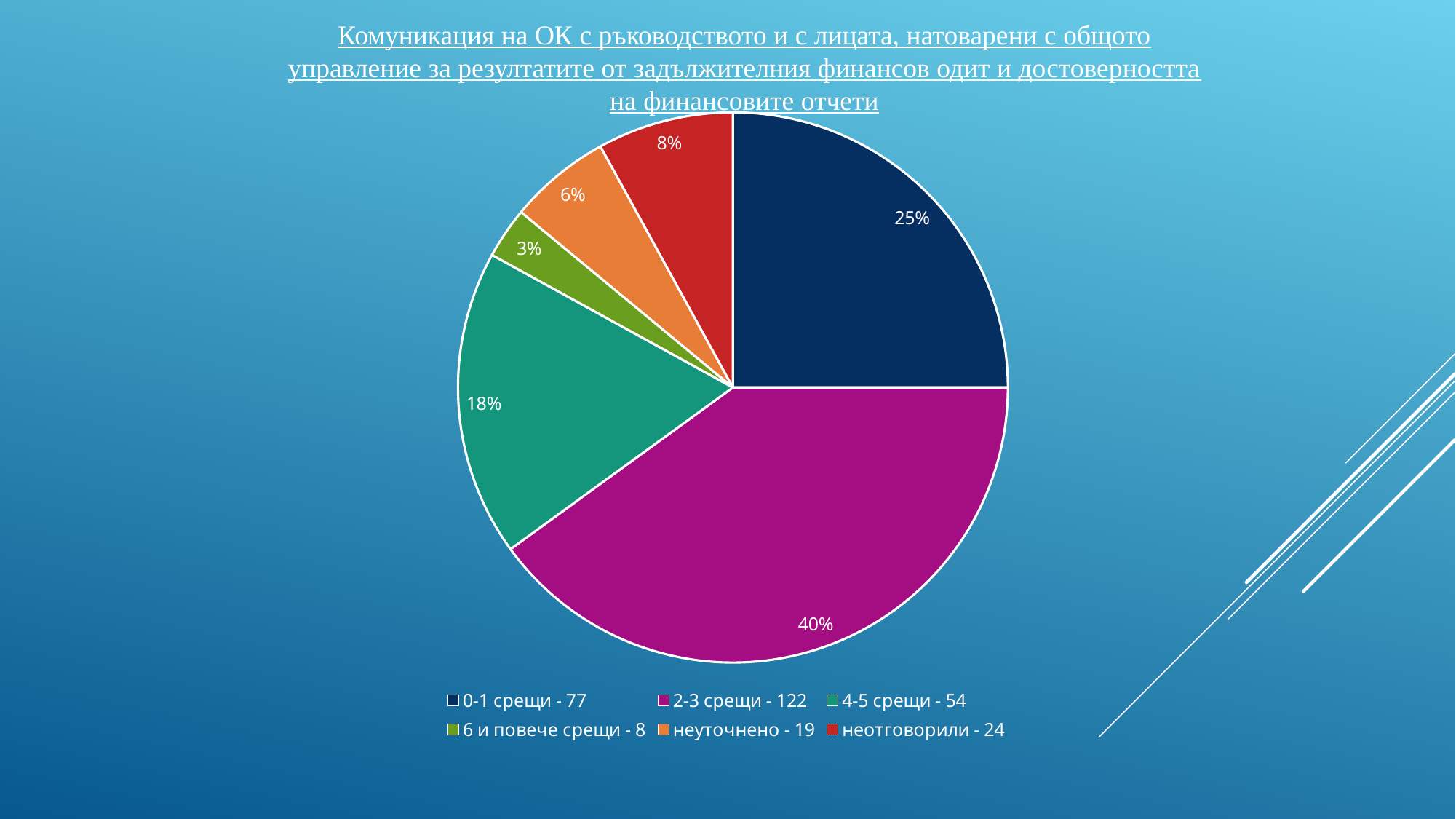
What percentage share does the slice for "неотговорили - 24" have? 8% What colour is the slice for "4-5 срещи - 54"? teal green Which slice is larger: "неуточнено - 19" or "неотговорили - 24"? неотговорили - 24 What percentage share does the slice for "4-5 срещи - 54" have? 18% What is the difference in percentage points between the "2-3 срещи - 122" slice and the "0-1 срещи - 77" slice? 15% What percentage share does the slice for "2-3 срещи - 122" have? 40% Which category has the smallest slice of the pie? 6 и повече срещи - 8 Which category has the largest slice of the pie? 2-3 срещи - 122 How many slices does the pie chart have? 6 What kind of chart is shown on the slide? pie chart